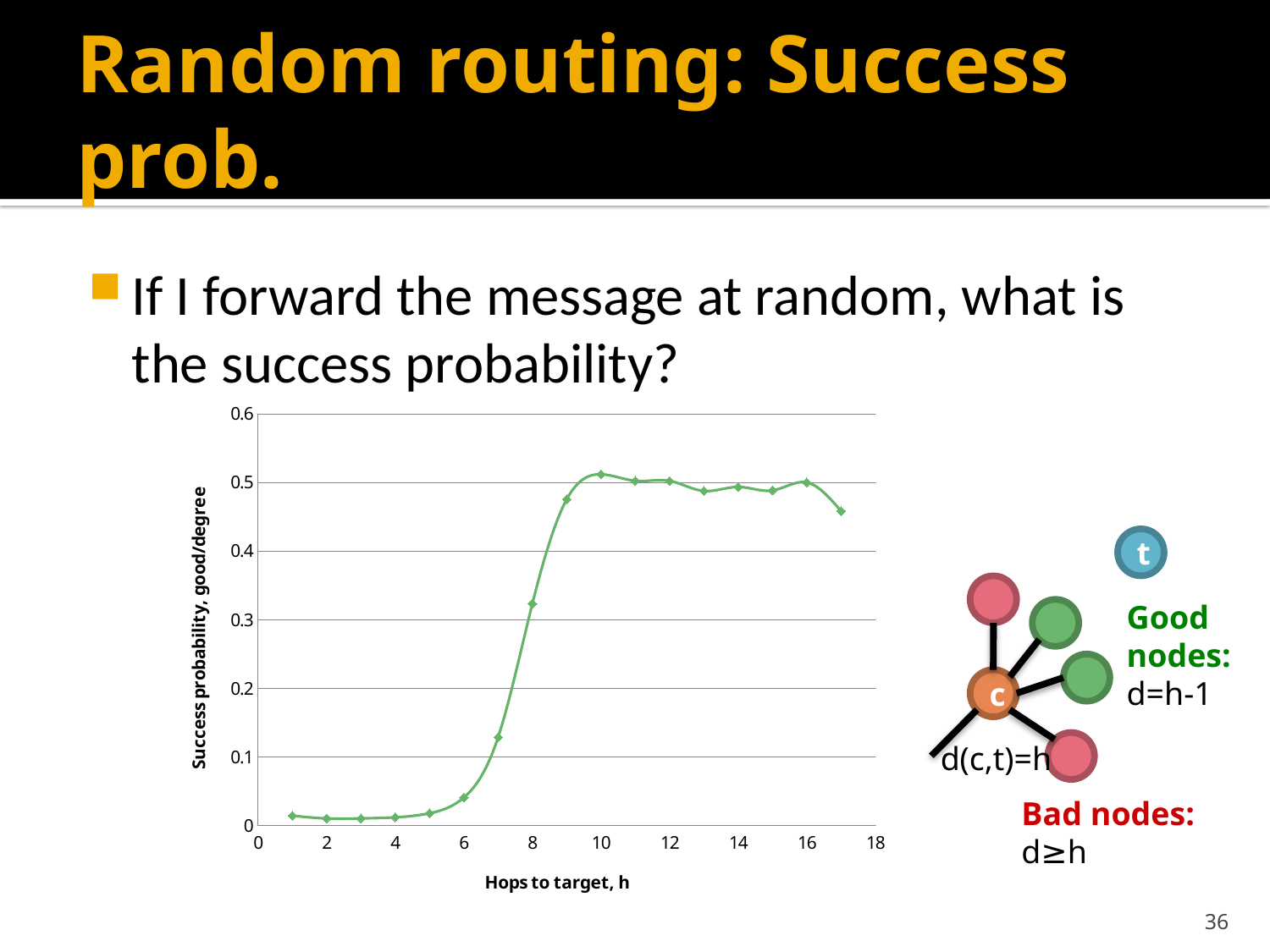
How many data points are plotted on the line? 17 Which has the higher success probability, h=9 or h=7? h=9 Is the success probability at h=8 greater or less than 0.3? greater Is the success probability at h=5 greater or less than 0.1? less Does the success probability rise or fall as h goes from 5 to 10? rise What is the label of the y axis? Success probability, good/degree What kind of chart is shown on the slide? line chart Which has the higher success probability, h=6 or h=8? h=8 Is the success probability at h=17 greater or less than 0.5? less What is the label of the x axis? Hops to target, h